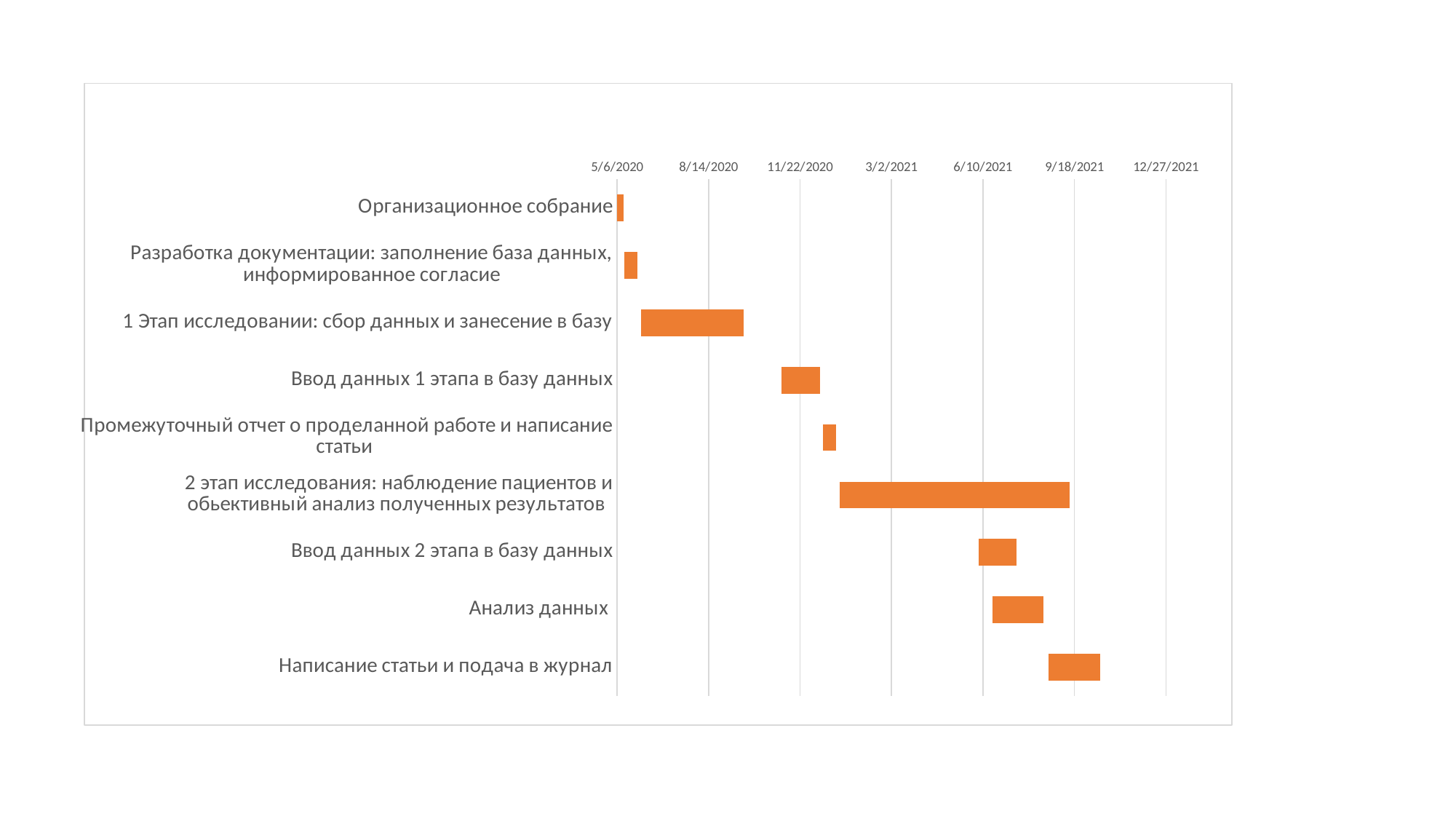
Does the bar for 'Написание статьи и подача в журнал' start before or after the 9/18/2021 axis tick? before What colour are the bars in the chart? Orange How many tasks (categories) are listed on the vertical axis of the chart? 9 What is the first date label shown on the horizontal axis? 5/6/2020 Which bar is longer: 'Анализ данных' or 'Промежуточный отчет о проделанной работе и написание статьи'? Анализ данных Does the bar for 'Ввод данных 1 этапа в базу данных' end before or after the 11/22/2020 axis tick? after Which task has the shortest bar in the chart? Организационное собрание What kind of chart is shown on the slide? Bar chart (Gantt chart) Which task has the longest bar in the chart? 2 этап исследования: наблюдение пациентов и обьективный анализ полученных результатов Which bar is longer: '1 Этап исследовании: сбор данных и занесение в базу' or 'Ввод данных 1 этапа в базу данных'? 1 Этап исследовании: сбор данных и занесение в базу Moving down the list of tasks, do the bars shift to the right (later dates) or to the left (earlier dates)? to the right (later dates) Does the bar for '1 Этап исследовании: сбор данных и занесение в базу' end before or after the 11/22/2020 axis tick? before